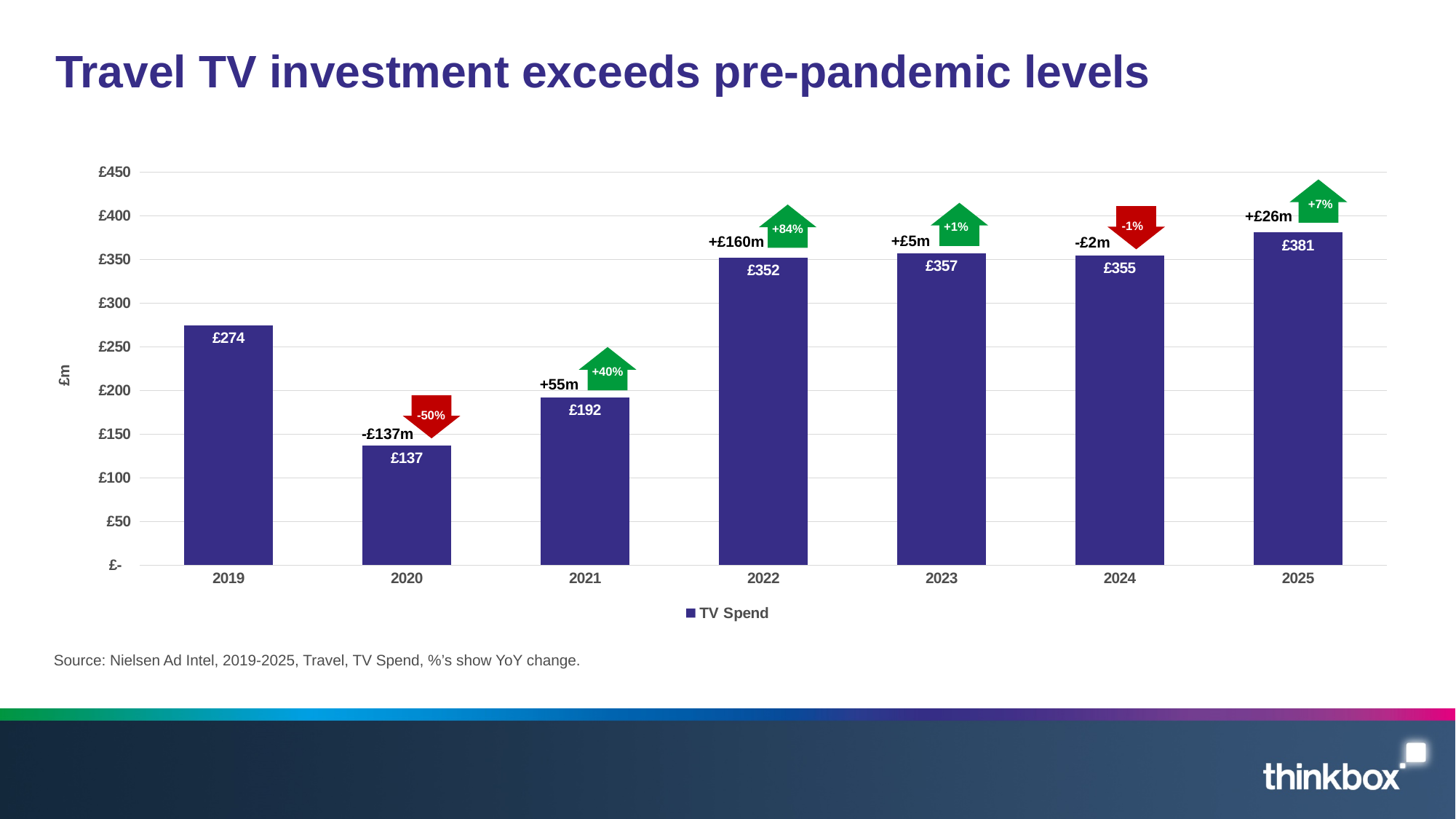
What kind of chart is shown on the slide? bar chart What is the TV Spend value for 2022? £352 Is the TV Spend value for 2023 greater or less than £300? greater Which year has the lowest TV Spend? 2020 How many years are shown on the x axis? 7 What is the TV Spend value for 2019? £274 How many series does the legend list? 1 What is the TV Spend value for 2025? £381 Which year has the larger TV Spend, 2021 or 2024? 2024 What YoY percentage change is shown for 2022? +84% Which year has the highest TV Spend? 2025 What is the difference in TV Spend between 2025 and 2019? £107